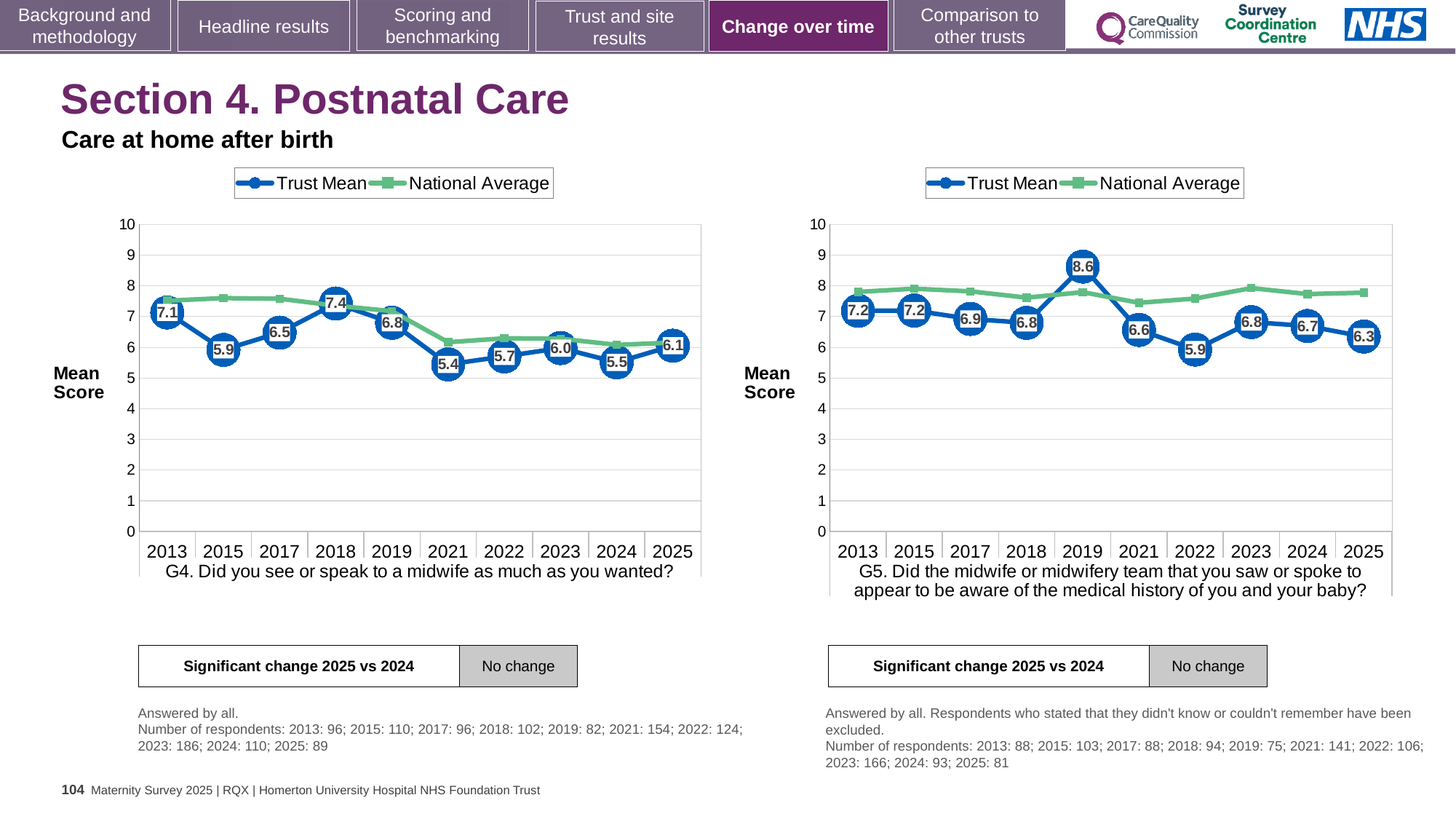
What kind of chart is the G5 chart? Line chart In the G5 chart, which year has the lowest Trust Mean? 2022 In the G5 chart, which year has the highest Trust Mean? 2019 In the G4 chart, is the National Average for 2013 greater or less than 7? greater In the G4 chart, what is the difference between the Trust Mean in 2018 and in 2021? 2.0 In the G4 chart, is the Trust Mean higher in 2025 or in 2024? 2025 In the G5 chart, what is the difference between the Trust Mean in 2019 and in 2025? 2.3 How many series does the legend of the G4 chart list? 2 How many years are plotted on the x axis of the G5 chart? 10 In the G4 chart, what is the Trust Mean for 2018? 7.4 In the G5 chart, what is the Trust Mean for 2019? 8.6 In the G4 chart, which year has the lowest Trust Mean? 2021